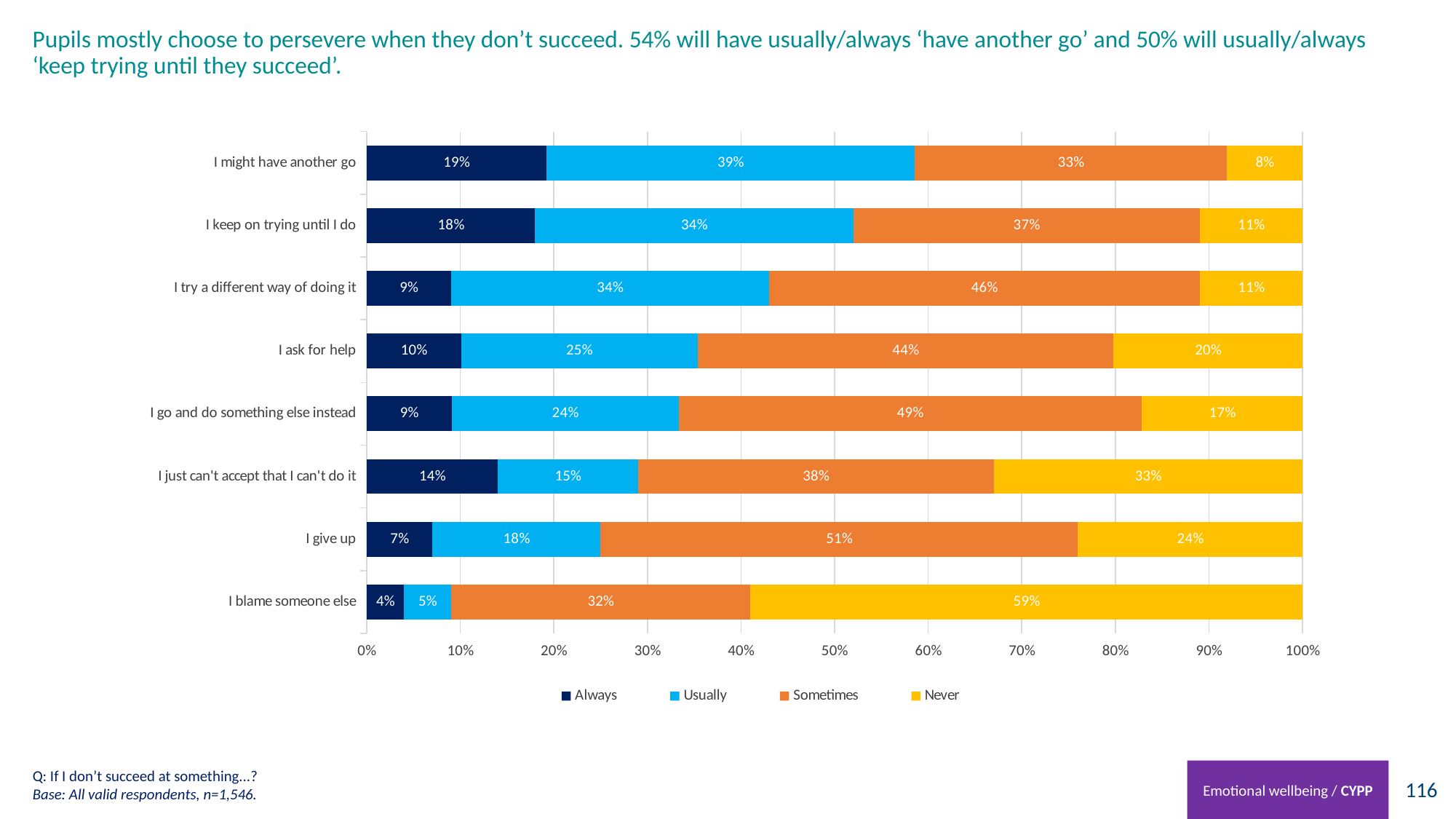
What percentage of pupils say they 'Always' 'might have another go'? 19% What is the difference between the 'Sometimes' values for 'I go and do something else instead' and 'I ask for help'? 5% Which category has the lowest 'Always' value? I blame someone else What is the combined 'Always' and 'Usually' percentage for 'I try a different way of doing it'? 43% How many categories (statements) are shown on the chart? 8 Which category has the highest 'Never' value? I blame someone else What percentage of pupils say they 'Sometimes' 'give up'? 51% What kind of chart is shown on the slide? Stacked bar chart Which is larger: the 'Usually' value for 'I might have another go' or for 'I keep on trying until I do'? I might have another go How many series does the legend list? 4 What percentage of pupils say they 'Usually' 'ask for help'? 25% What percentage of pupils say they 'Never' 'blame someone else'? 59%